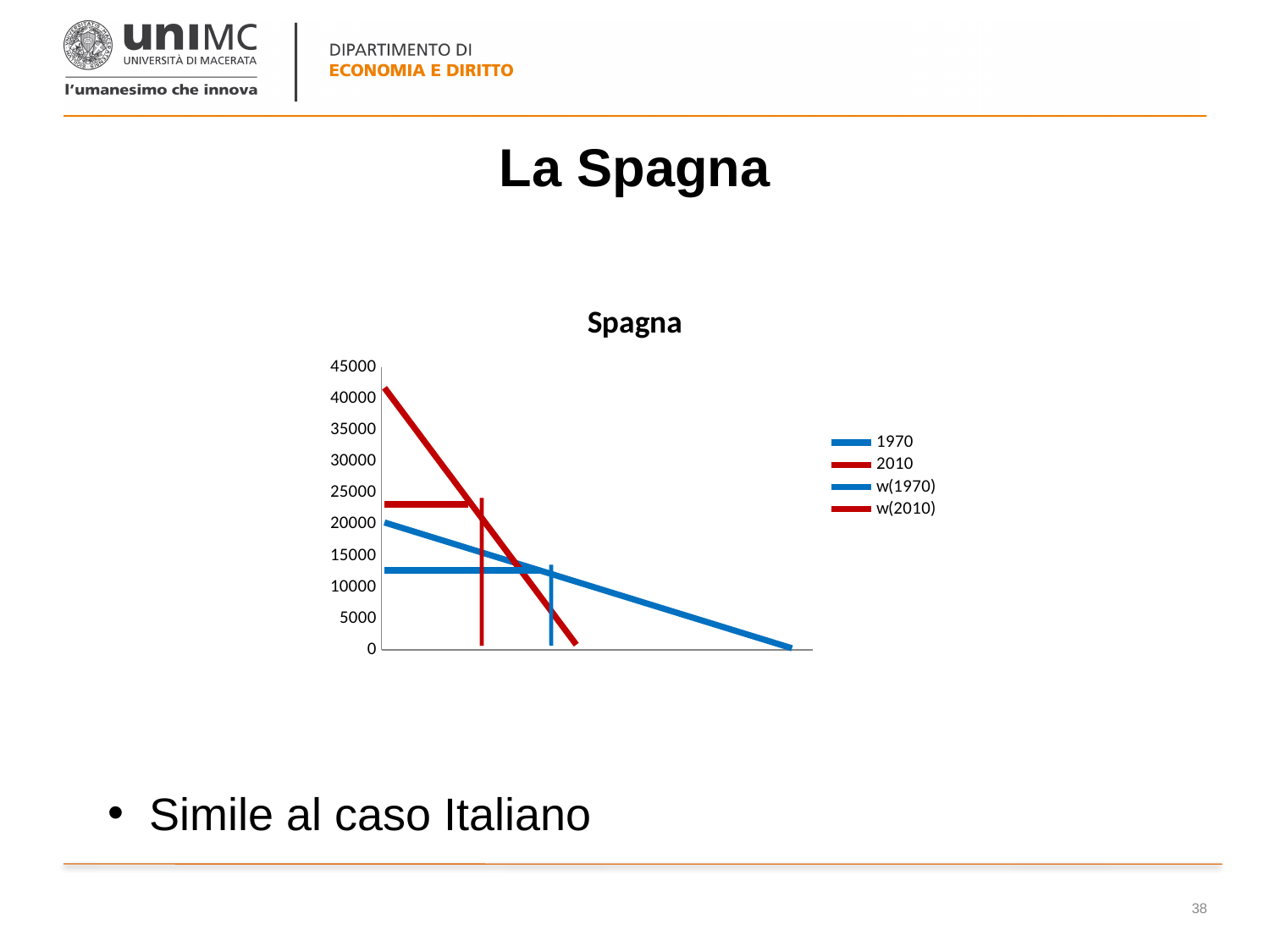
What is the title of the chart? Spagna Which line starts at a higher value on the left, 1970 or 2010? 2010 Is the starting value of the 2010 line greater or less than 40000? greater Does the 1970 line rise or fall from left to right? fall What kind of chart is shown on the slide? line chart What is the highest value shown on the vertical axis? 45000 How many series does the legend list? 4 Which horizontal line is at a higher level, w(1970) or w(2010)? w(2010) Is the level of the horizontal w(2010) line greater or less than 20000? greater Is the level of the horizontal w(1970) line greater or less than 15000? less Does the 2010 line rise or fall from left to right? fall Which series are listed in the legend? 1970, 2010, w(1970), w(2010)